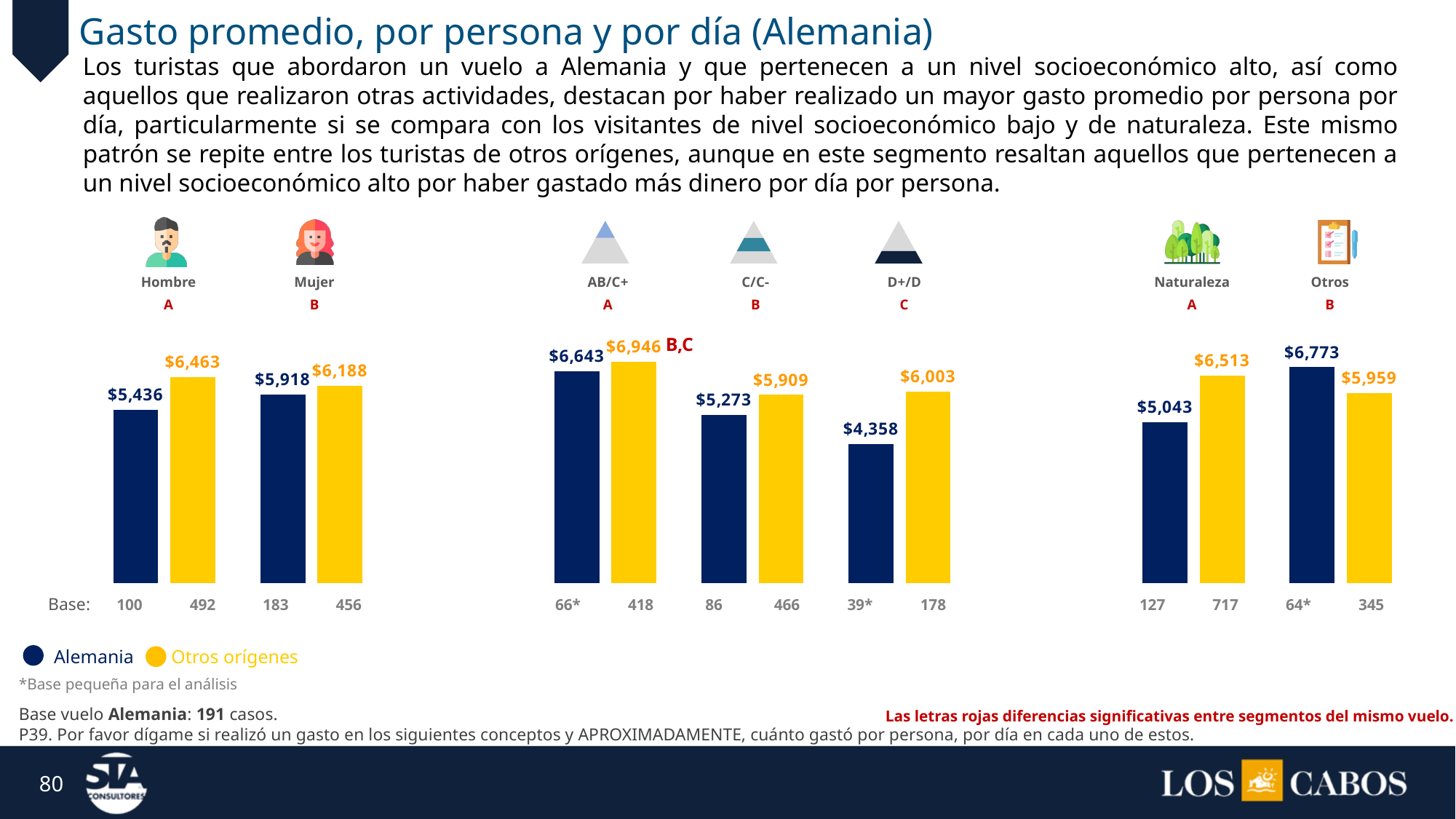
In the socioeconomic level chart (AB/C+, C/C-, D+/D), what is the Alemania value for D+/D? $4,358 In the socioeconomic level chart (AB/C+, C/C-, D+/D), which category has the highest Otros orígenes value? AB/C+ In the activities chart (Naturaleza/Otros), which is larger for Naturaleza: the Alemania value or the Otros orígenes value? Otros orígenes In the gender chart (Hombre/Mujer), what is the Otros orígenes value for Mujer? $6,188 How many series does the legend list? 2 In the activities chart (Naturaleza/Otros), what is the difference between the Otros orígenes and Alemania values for Naturaleza? $1,470 In the activities chart (Naturaleza/Otros), what is the Alemania value for Otros? $6,773 In the gender chart (Hombre/Mujer), what is the Alemania value for Hombre? $5,436 In the socioeconomic level chart (AB/C+, C/C-, D+/D), what is the difference between the Otros orígenes and Alemania values for D+/D? $1,645 In the socioeconomic level chart (AB/C+, C/C-, D+/D), which category has the lowest Alemania value? D+/D What kind of chart is used on this slide? Bar chart How many categories are shown in the socioeconomic level chart (AB/C+, C/C-, D+/D)? 3